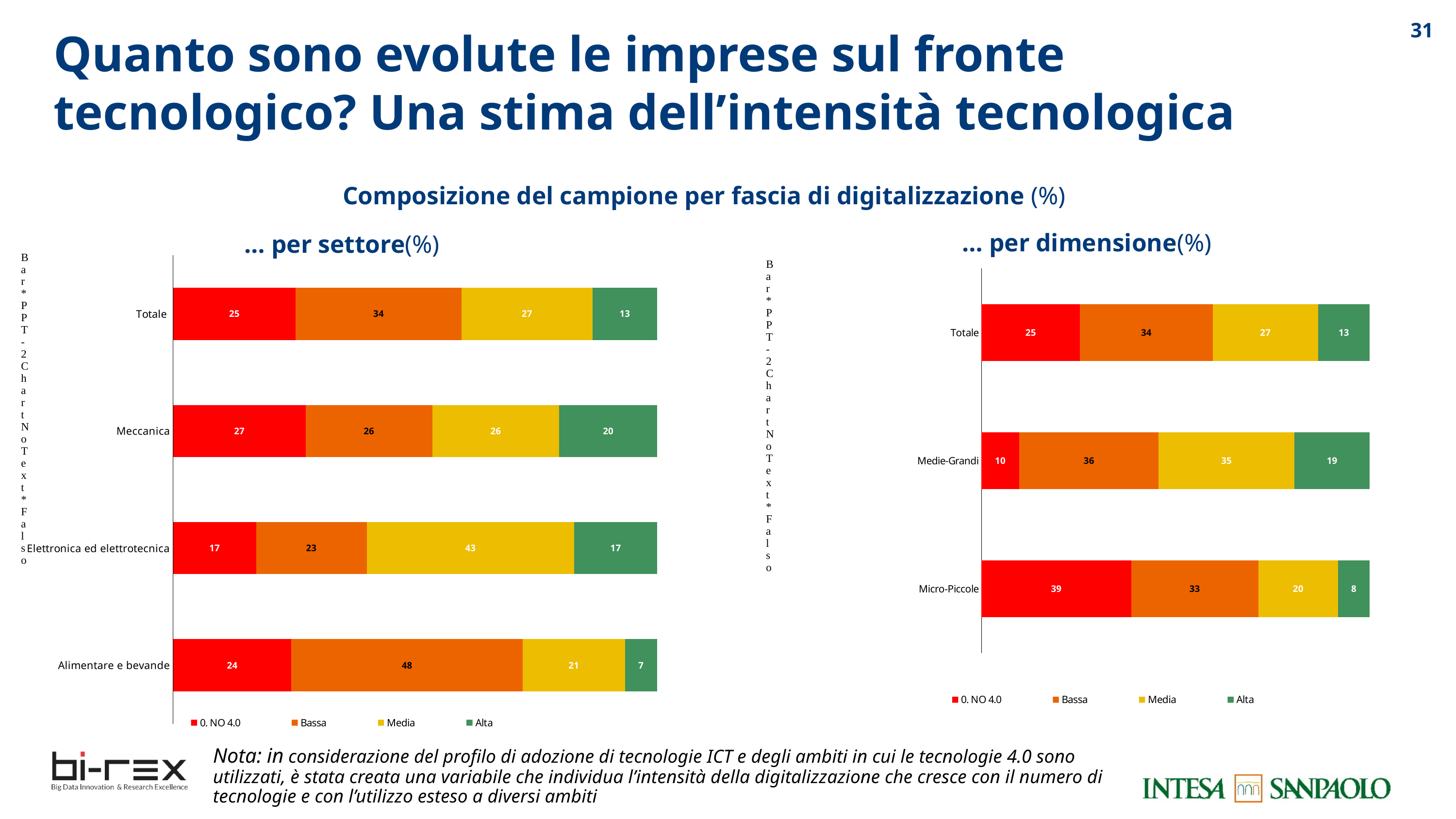
In the '… per settore' chart, which category has the highest value for Alta? Meccanica In the '… per dimensione' chart, what is the value of Alta for Medie-Grandi? 19 In the '… per dimensione' chart, what is the total of the stacked bar for Micro-Piccole? 100 In the '… per dimensione' chart, which category has the lowest value for 0. NO 4.0? Medie-Grandi In the '… per settore' chart, what is the value of Bassa for Alimentare e bevande? 48 In the '… per dimensione' chart, what is the value of 0. NO 4.0 for Micro-Piccole? 39 In the '… per settore' chart, what is the value of Media for Elettronica ed elettrotecnica? 43 What type of chart is the '… per settore' chart? Stacked bar chart How many categories are shown in the '… per dimensione' chart? 3 In the '… per settore' chart, what is the difference between the Bassa values for Alimentare e bevande and Meccanica? 22 In the '… per dimensione' chart, which is larger: the Media value for Medie-Grandi or for Micro-Piccole? Medie-Grandi How many series does the legend of the '… per settore' chart list? 4